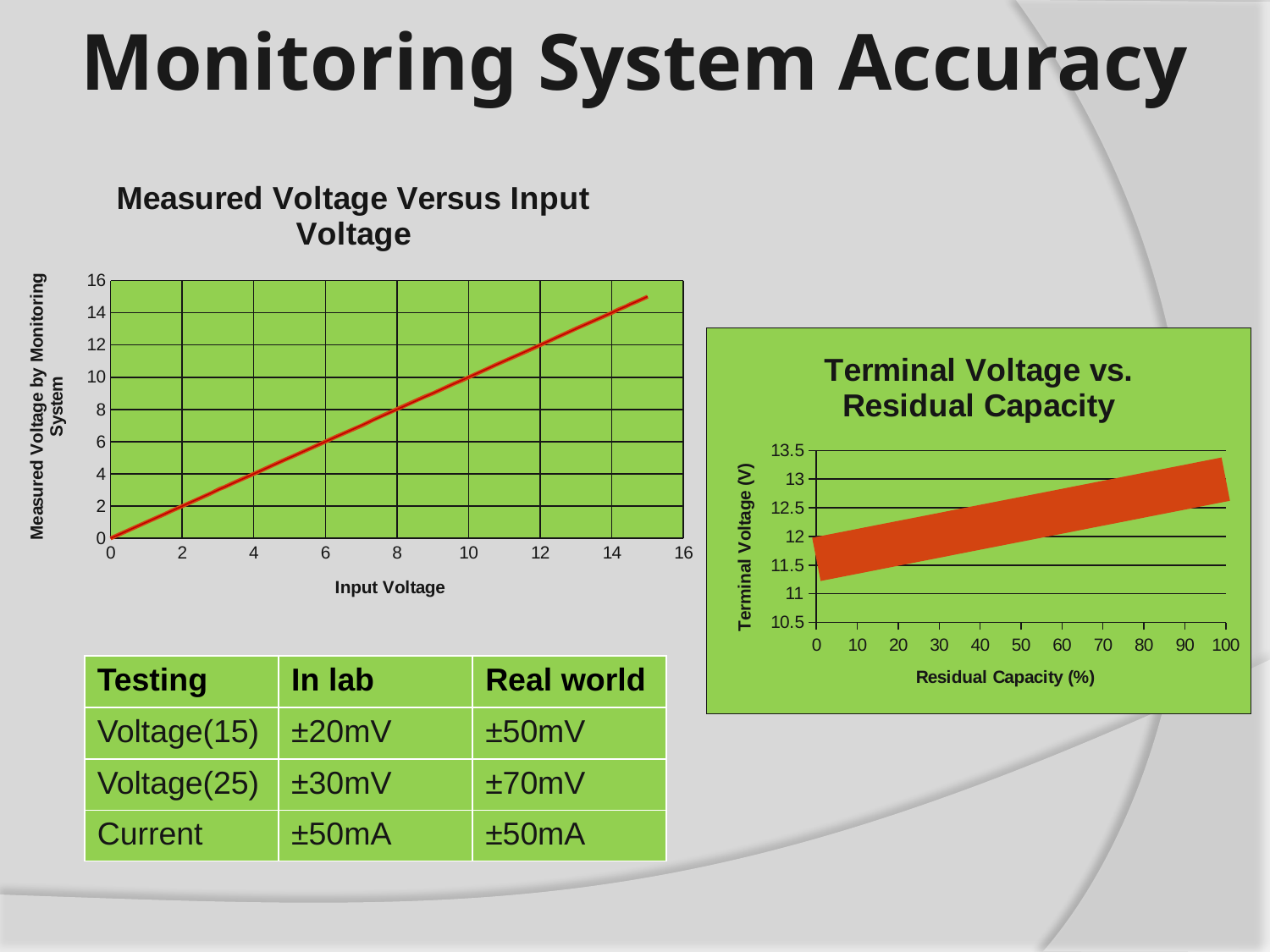
In the "Terminal Voltage vs. Residual Capacity" chart, is the terminal voltage at 100% residual capacity greater or less than 12.5? greater What type of chart is the "Measured Voltage Versus Input Voltage" chart? line chart What is the x-axis title of the "Measured Voltage Versus Input Voltage" chart? Input Voltage In the "Measured Voltage Versus Input Voltage" chart, what is the measured voltage when the input voltage is 0? 0 In the "Measured Voltage Versus Input Voltage" chart, is the measured voltage at an input voltage of 2 greater or less than 6? less In the "Terminal Voltage vs. Residual Capacity" chart, which has the higher terminal voltage: 10% residual capacity or 90% residual capacity? 90% residual capacity In the "Terminal Voltage vs. Residual Capacity" chart, does the terminal voltage rise or fall as residual capacity increases? rise In the "Measured Voltage Versus Input Voltage" chart, does the measured voltage rise or fall as input voltage increases? rise In the "Measured Voltage Versus Input Voltage" chart, is the measured voltage at an input voltage of 14 greater or less than 10? greater What is the x-axis title of the "Terminal Voltage vs. Residual Capacity" chart? Residual Capacity (%)